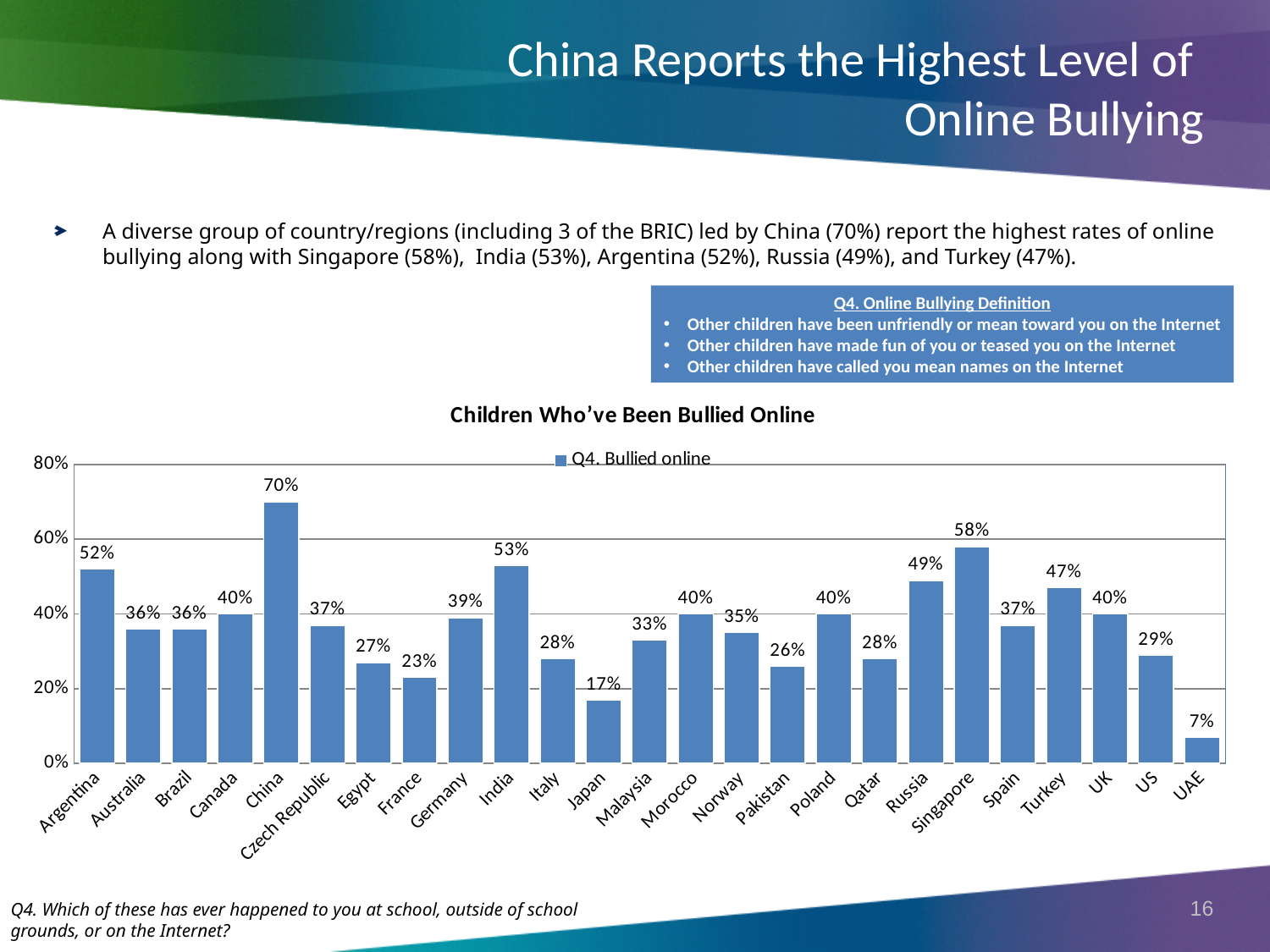
Which country/region has the highest value in the chart? China Is the value for Egypt greater or less than 40%? less What is the title of the chart? Children Who've Been Bullied Online What is the difference between the values for China and Singapore? 12% What is the value for Japan in the chart? 17% How many series does the legend list? 1 Which country/region has the lowest value in the chart? UAE What kind of chart is shown on the slide? Bar chart How many countries/regions are shown in the chart? 25 What is the value for Singapore in the chart? 58% Which has a larger value, India or Russia? India What is the value for China in the chart? 70%